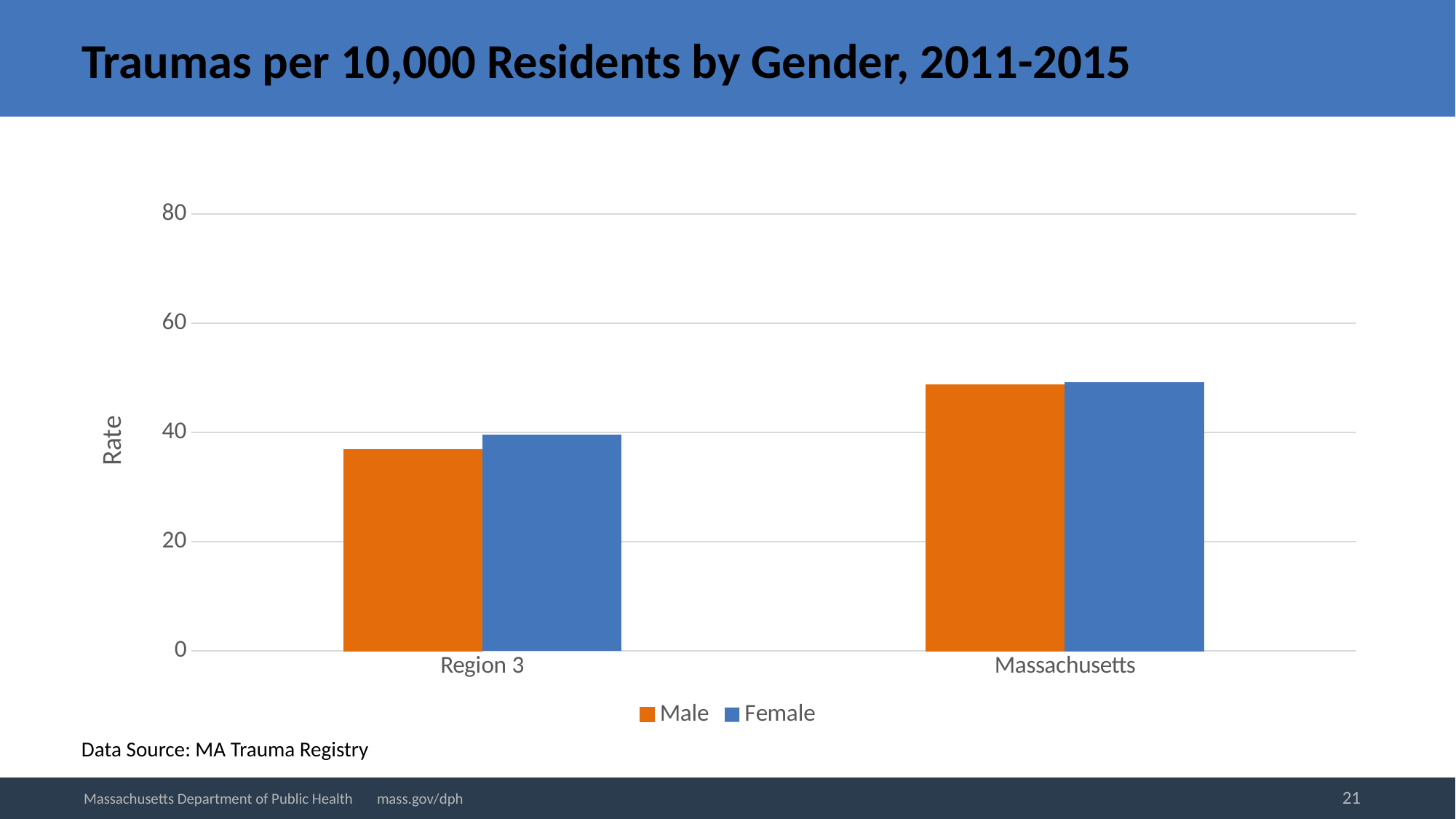
What kind of chart is shown on the slide? bar chart What is the label of the vertical axis? Rate In Region 3, which is higher, the Male rate or the Female rate? Female Is the Male value for Region 3 greater or less than 40? less How many series does the legend list? 2 Which has the higher Female rate, Region 3 or Massachusetts? Massachusetts Is the Male value for Massachusetts greater or less than 40? greater Is the Male value for Region 3 greater or less than 20? greater What is the title of the chart? Traumas per 10,000 Residents by Gender, 2011-2015 How many categories are shown on the x axis? 2 Which has the higher Male rate, Region 3 or Massachusetts? Massachusetts